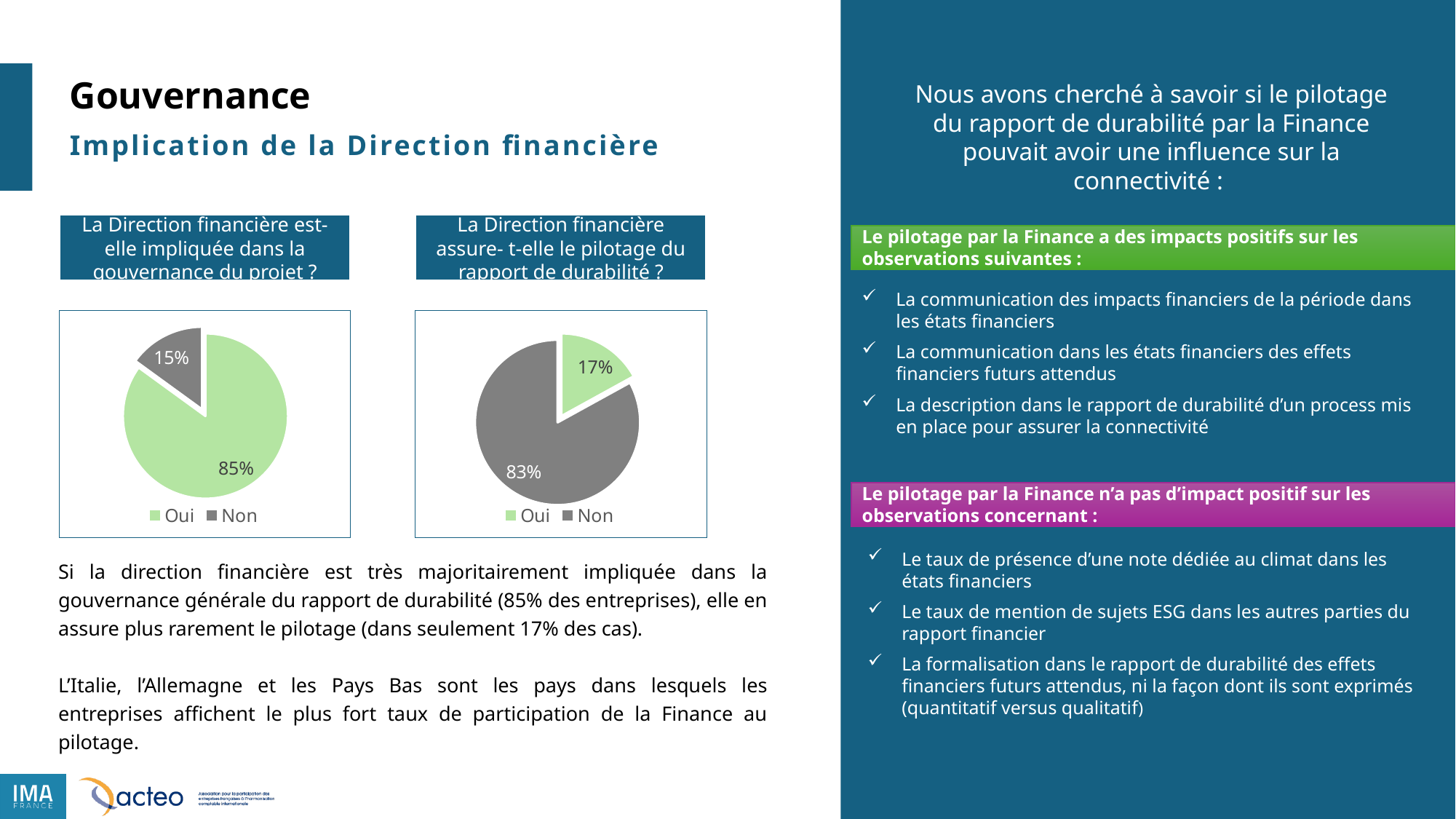
In the left pie chart, what is the difference between the Oui and Non shares? 70% In the right pie chart (La Direction financière assure-t-elle le pilotage du rapport de durabilité ?), what is the value for Oui? 17% How many categories does the legend of the right pie chart list? 2 In the left pie chart (La Direction financière est-elle impliquée dans la gouvernance du projet ?), what is the value for Oui? 85% In the right pie chart, which category has the smallest share? Oui In the right pie chart, what is the difference between the Non and Oui shares? 66% What type of chart is used on the left side of the slide? Pie chart Is the Oui share larger in the left pie chart or in the right pie chart? Left pie chart In the right pie chart, which colour represents Non? Grey In the right pie chart (La Direction financière assure-t-elle le pilotage du rapport de durabilité ?), what is the value for Non? 83% In the left pie chart, which category has the largest share? Oui In the left pie chart (La Direction financière est-elle impliquée dans la gouvernance du projet ?), what is the value for Non? 15%